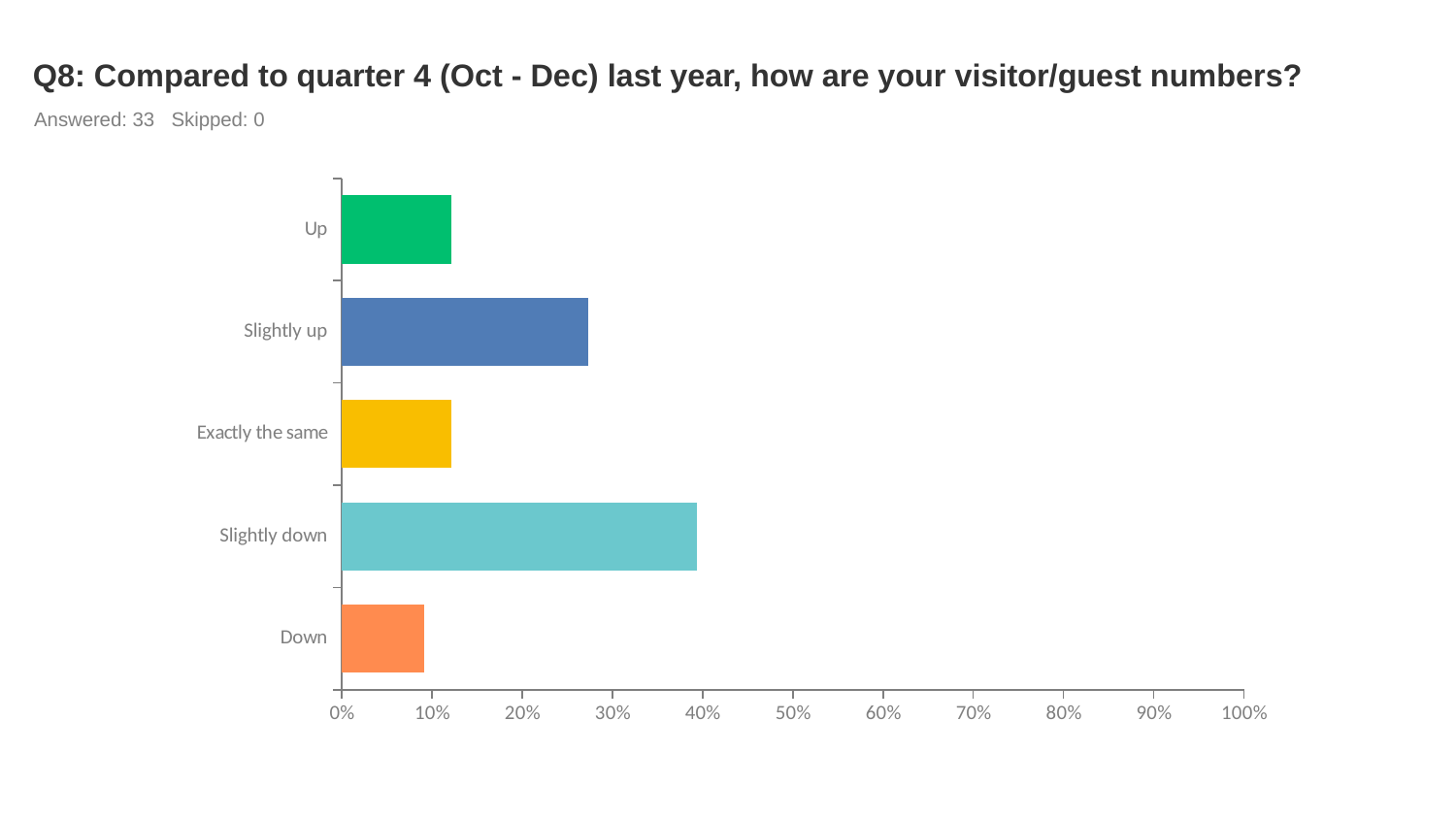
What kind of chart is shown on the slide? bar chart Which is larger, the value for Slightly down or the value for Slightly up? Slightly down Which response category has the highest value? Slightly down Is the value for Slightly down greater or less than 50%? less How many respondents answered the question shown on the slide? 33 How many response categories are shown on the chart? 5 Is the value for Down greater or less than 20%? less Is the value for Slightly up greater or less than 20%? greater Which response category has the lowest value? Down Which is larger, the value for Slightly up or the value for Up? Slightly up